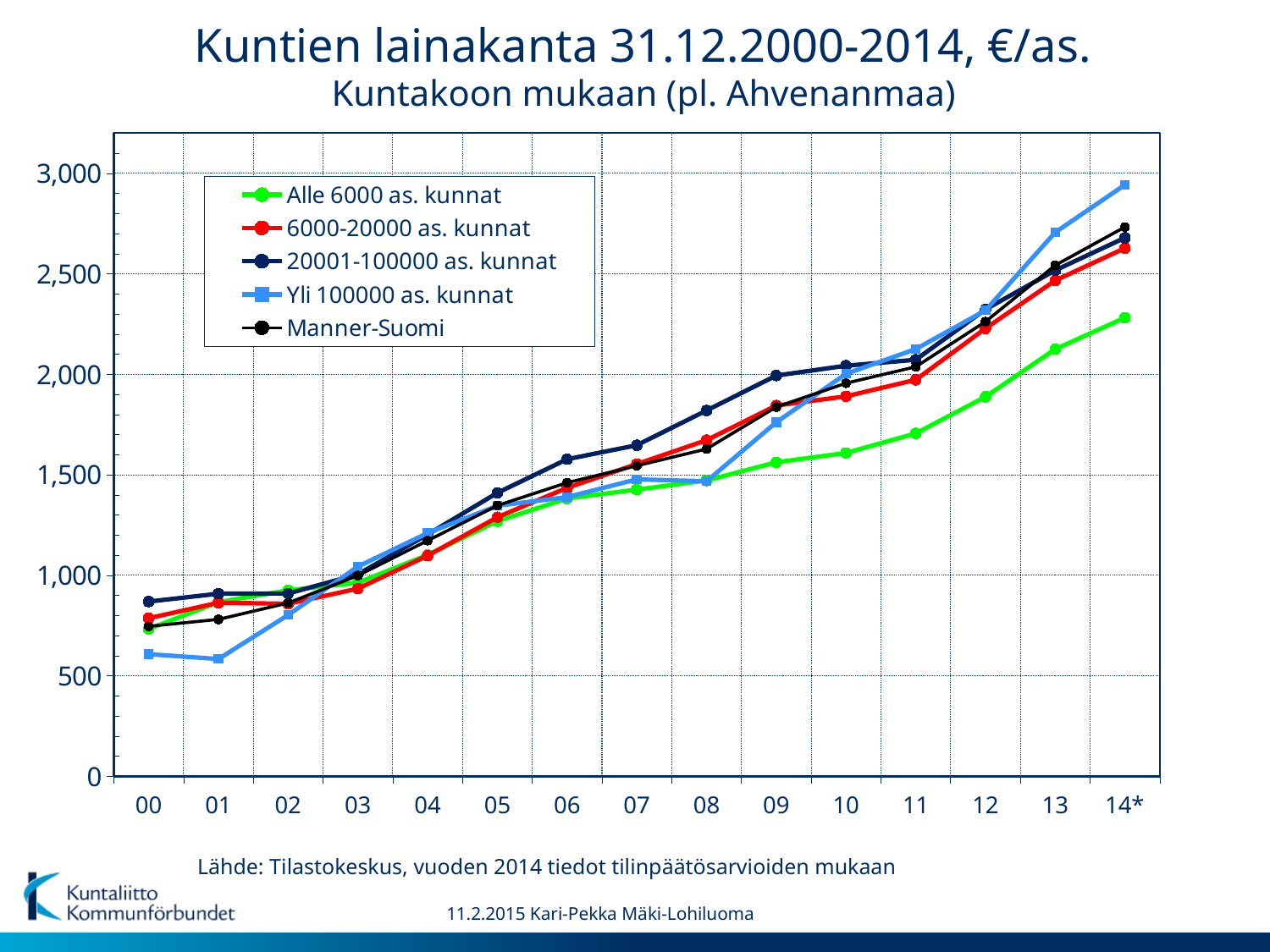
In 01, which is larger: the value for 20001-100000 as. kunnat or the value for Yli 100000 as. kunnat? 20001-100000 as. kunnat Which series is drawn in green? Alle 6000 as. kunnat How many years are shown along the x axis? 15 What kind of chart is shown on the slide? line chart Is the value for Yli 100000 as. kunnat in 00 greater or less than 1,000? less Is the value for Yli 100000 as. kunnat in 14* greater or less than 2,500? greater Is the value for Alle 6000 as. kunnat in 11 greater or less than 2,000? less Which series has the lowest value in 00? Yli 100000 as. kunnat How many series does the legend list? 5 Which series has the highest value in 14*? Yli 100000 as. kunnat Which series has the lowest value in 14*? Alle 6000 as. kunnat Does the Manner-Suomi series generally rise or fall from 00 to 14*? rise